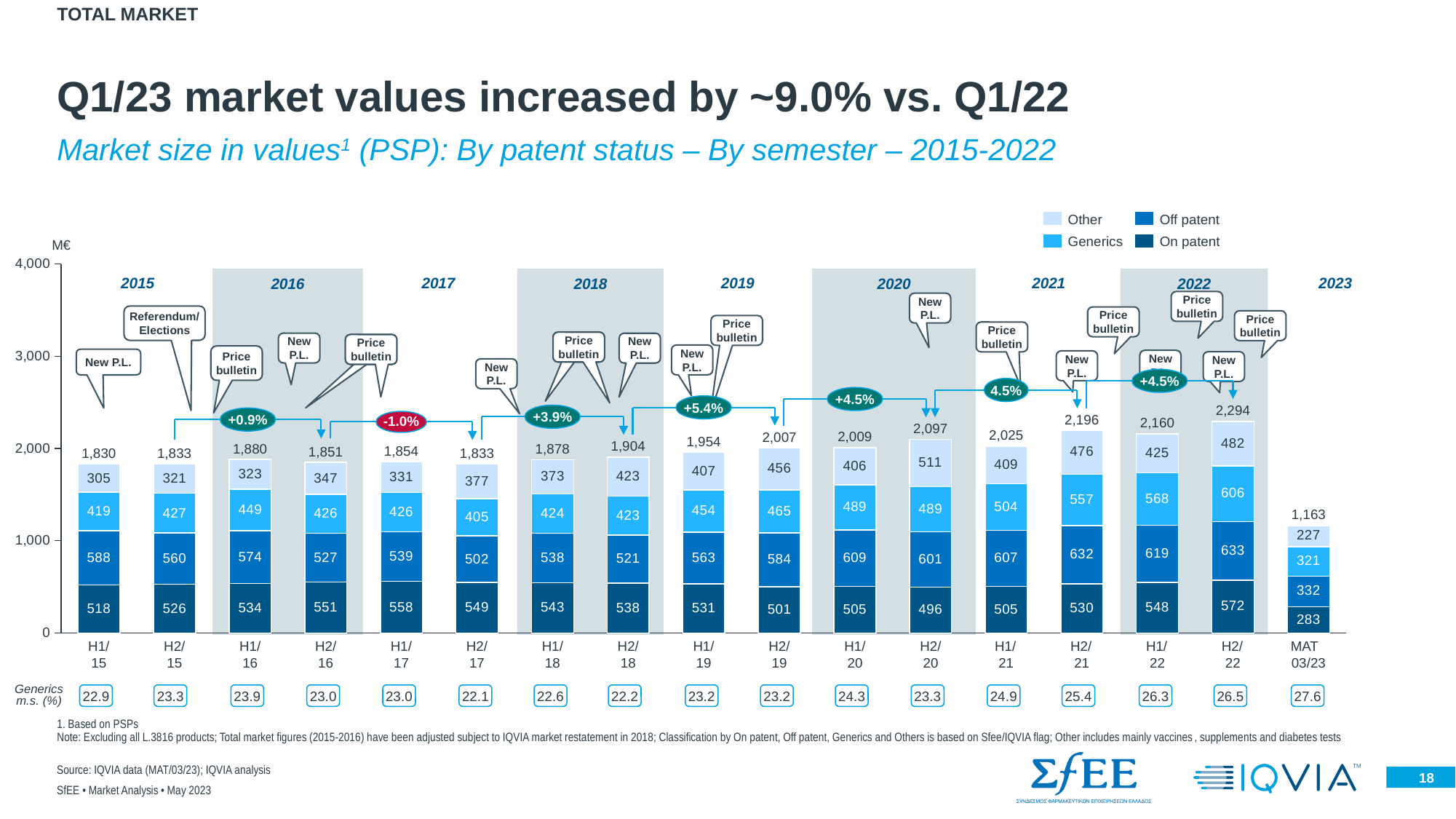
Which is larger, the Off patent value for H1/19 or the Off patent value for H2/19? H2/19 What percentage change is shown between H2/21 and H2/22? +4.5% What is the difference between the total for H2/22 and the total for H1/22? 134 What is the Generics value for H1/20? 489 How many bars are plotted on the chart? 17 Which bar has the lowest total market value? MAT 03/23 What is the Generics market share (%) shown for MAT 03/23? 27.6 What kind of chart is shown on the slide? Stacked bar chart How many series does the legend list? 4 What is the total market value shown for H2/22? 2,294 Which bar has the highest total market value? H2/22 What is the On patent value for H2/16? 551